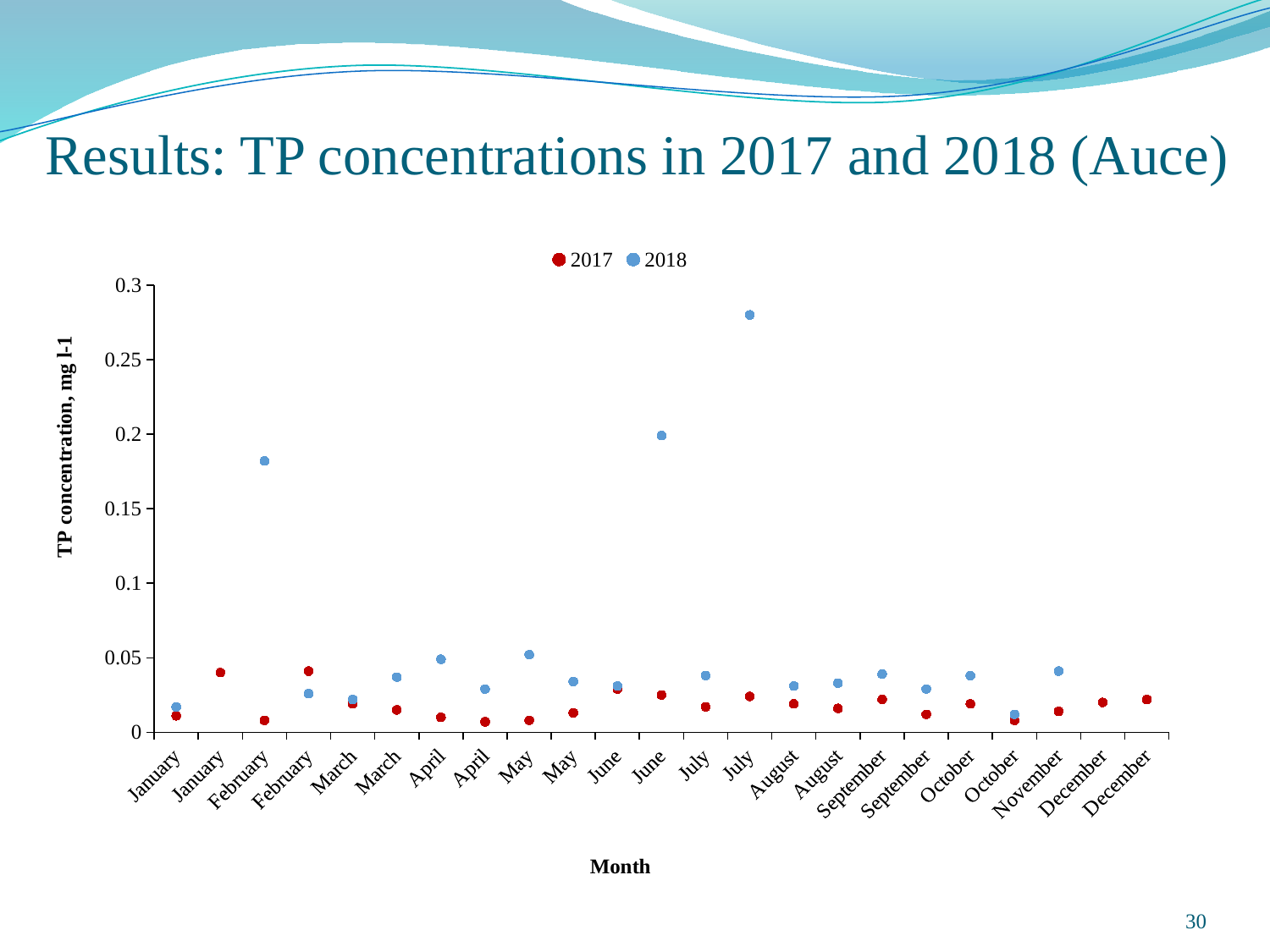
Is the 2017 value at the second January point greater or less than 0.05? less What is the label of the vertical axis? TP concentration, mg l-1 At the second July point, which series has the larger value, 2017 or 2018? 2018 How many series does the legend list? 2 Is the highest 2018 value (in July) greater or less than 0.25? greater What are the two series named in the legend? 2017 and 2018 In which month does the 2018 series reach its highest value? July Is the 2018 value at the second June point greater or less than 0.15? greater What kind of chart is shown on the slide? scatter chart At the first February point, which series has the larger value, 2017 or 2018? 2018 Which series contains the highest point on the chart? 2018